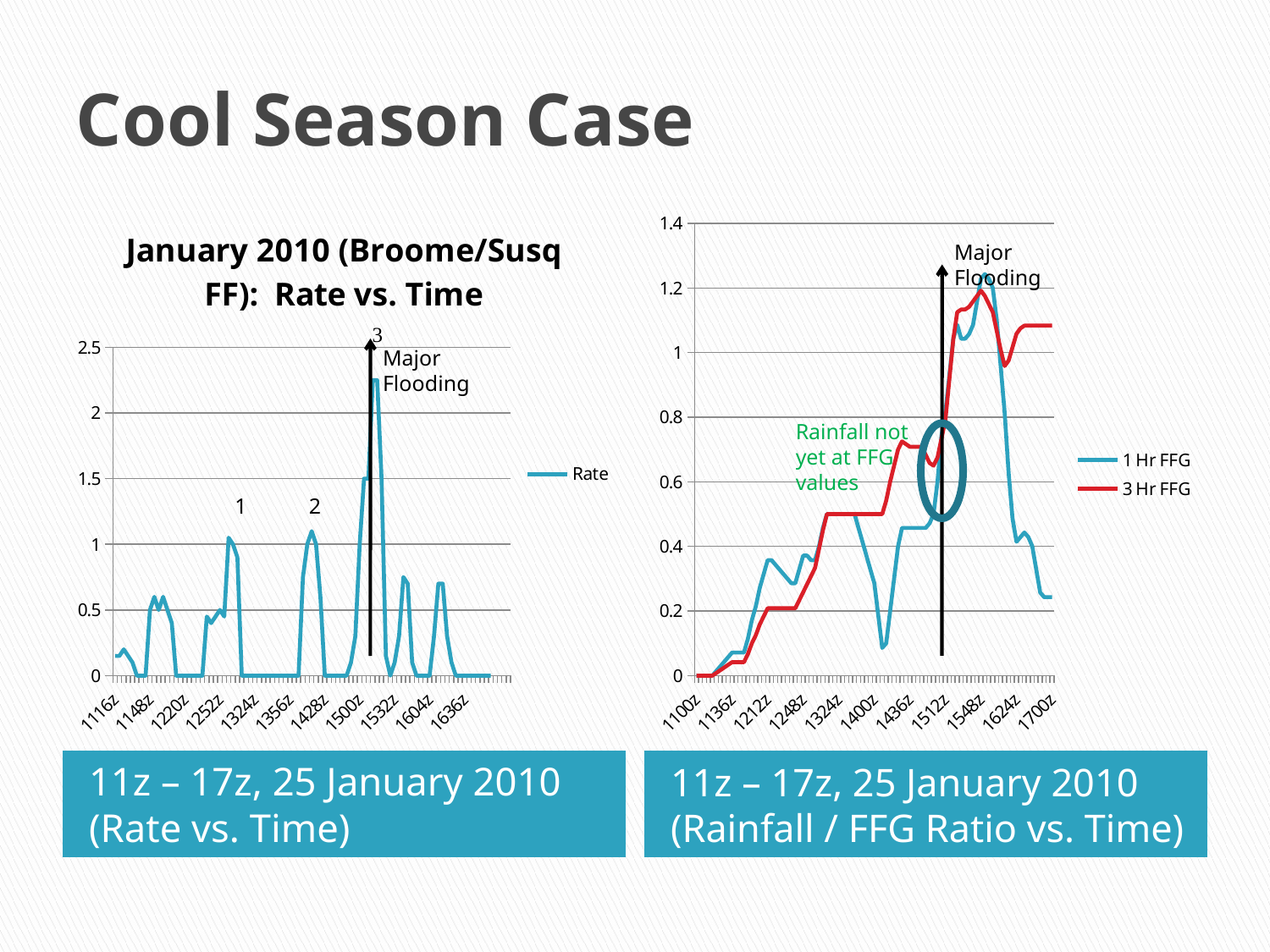
How many series does the legend of the right chart list? 2 In the right chart, is the 3 Hr FFG value at 1700z greater or less than 1? greater What type of chart is the right chart on the slide? line chart What type of chart is the left chart titled "January 2010 (Broome/Susq FF): Rate vs. Time"? line chart In the right chart, does the 3 Hr FFG series generally rise or fall from 1100z to 1548z? rise In the left chart, is the Rate value at 1428z greater or less than 1.5? less In the right chart, which series has the larger value at 1700z, 1 Hr FFG or 3 Hr FFG? 3 Hr FFG What is the title of the left chart? January 2010 (Broome/Susq FF): Rate vs. Time In the right chart, is the 1 Hr FFG value at 1700z greater or less than 0.4? less What are the two series named in the legend of the right chart? 1 Hr FFG and 3 Hr FFG How many series does the legend of the left chart list? 1